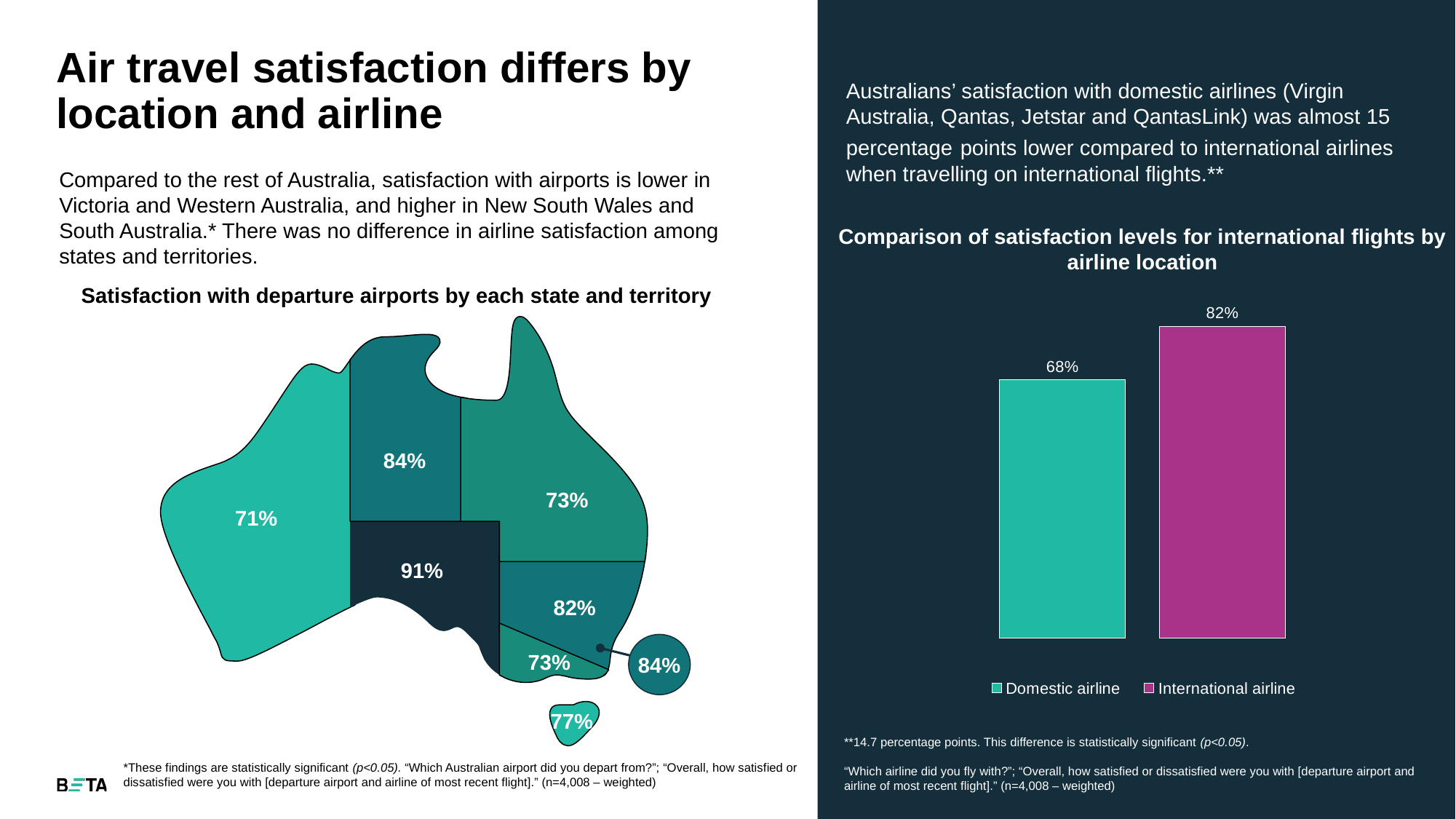
In the 'Satisfaction with departure airports by each state and territory' map, what is the highest percentage shown? 91% How many entries does the legend of the 'Comparison of satisfaction levels for international flights by airline location' chart list? 2 In the 'Satisfaction with departure airports by each state and territory' map, what is the lowest percentage shown? 71% In the 'Comparison of satisfaction levels for international flights by airline location' chart, which bar is higher? International airline In the 'Comparison of satisfaction levels for international flights by airline location' chart, which bar is lowest? Domestic airline In the 'Comparison of satisfaction levels for international flights by airline location' chart, what is the difference in percentage points between International airline and Domestic airline? 14 What kind of chart is the 'Comparison of satisfaction levels for international flights by airline location' chart? bar chart In the 'Comparison of satisfaction levels for international flights by airline location' chart, is the value for Domestic airline larger or smaller than the value for International airline? smaller How many bars are plotted in the 'Comparison of satisfaction levels for international flights by airline location' chart? 2 How many percentage values are labelled on the 'Satisfaction with departure airports by each state and territory' map? 8 In the 'Comparison of satisfaction levels for international flights by airline location' chart, what is the value for Domestic airline? 68% In the 'Comparison of satisfaction levels for international flights by airline location' chart, what is the value for International airline? 82%